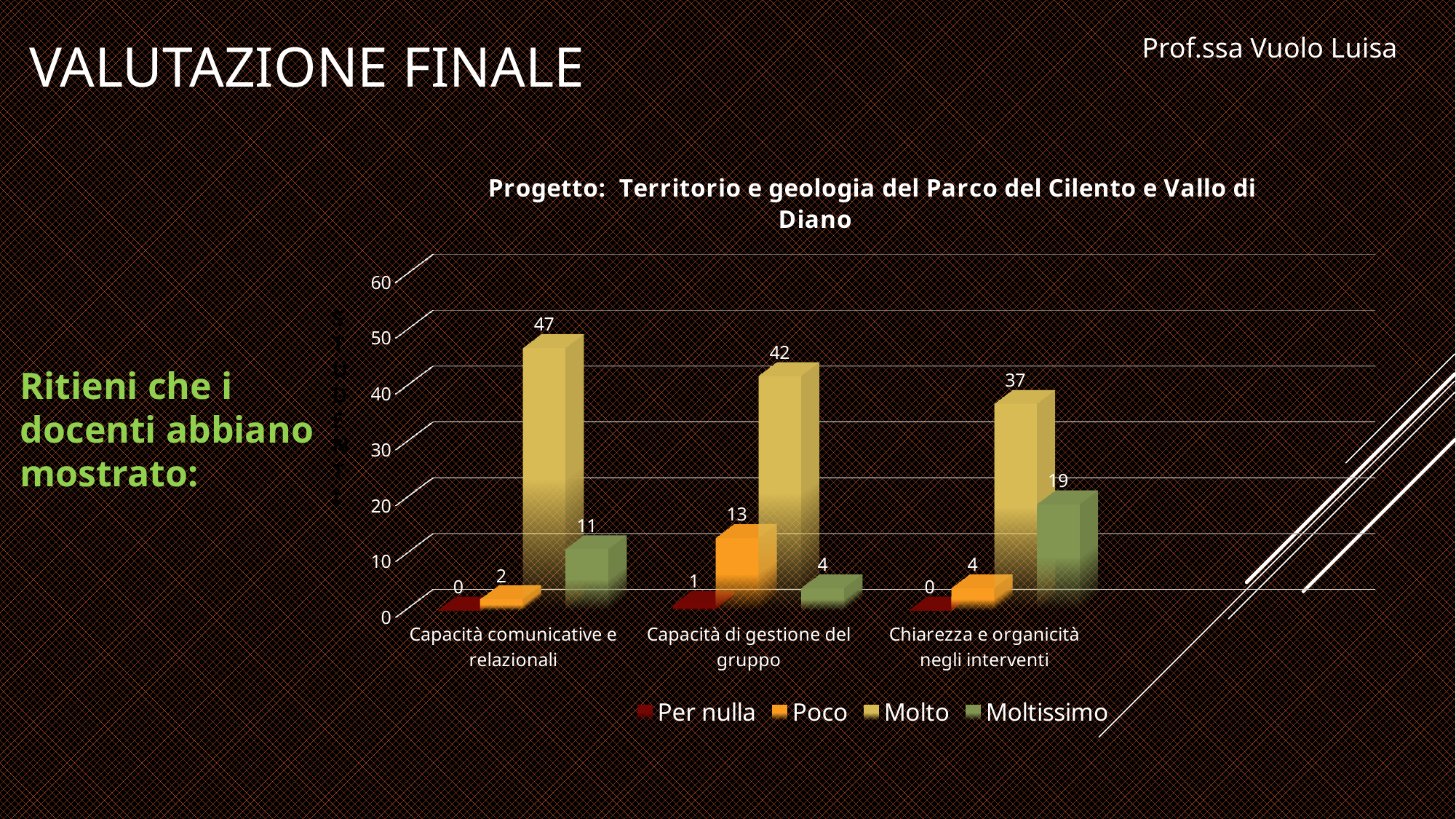
What is the difference between the Molto values for Capacità comunicative e relazionali and Chiarezza e organicità negli interventi? 10 What is the value for Moltissimo in the Chiarezza e organicità negli interventi category? 19 What is the value for Molto in the Capacità comunicative e relazionali category? 47 How many series does the legend list? 4 What is the title of the chart? Progetto: Territorio e geologia del Parco del Cilento e Vallo di Diano Which category has the lowest value for Moltissimo? Capacità di gestione del gruppo How many categories are shown on the x axis? 3 Which is larger: the Moltissimo value for Capacità comunicative e relazionali or for Chiarezza e organicità negli interventi? Chiarezza e organicità negli interventi What is the value for Poco in the Capacità di gestione del gruppo category? 13 What is the value for Per nulla in the Capacità di gestione del gruppo category? 1 Which category has the highest value for Molto? Capacità comunicative e relazionali What kind of chart is shown on the slide? Bar chart